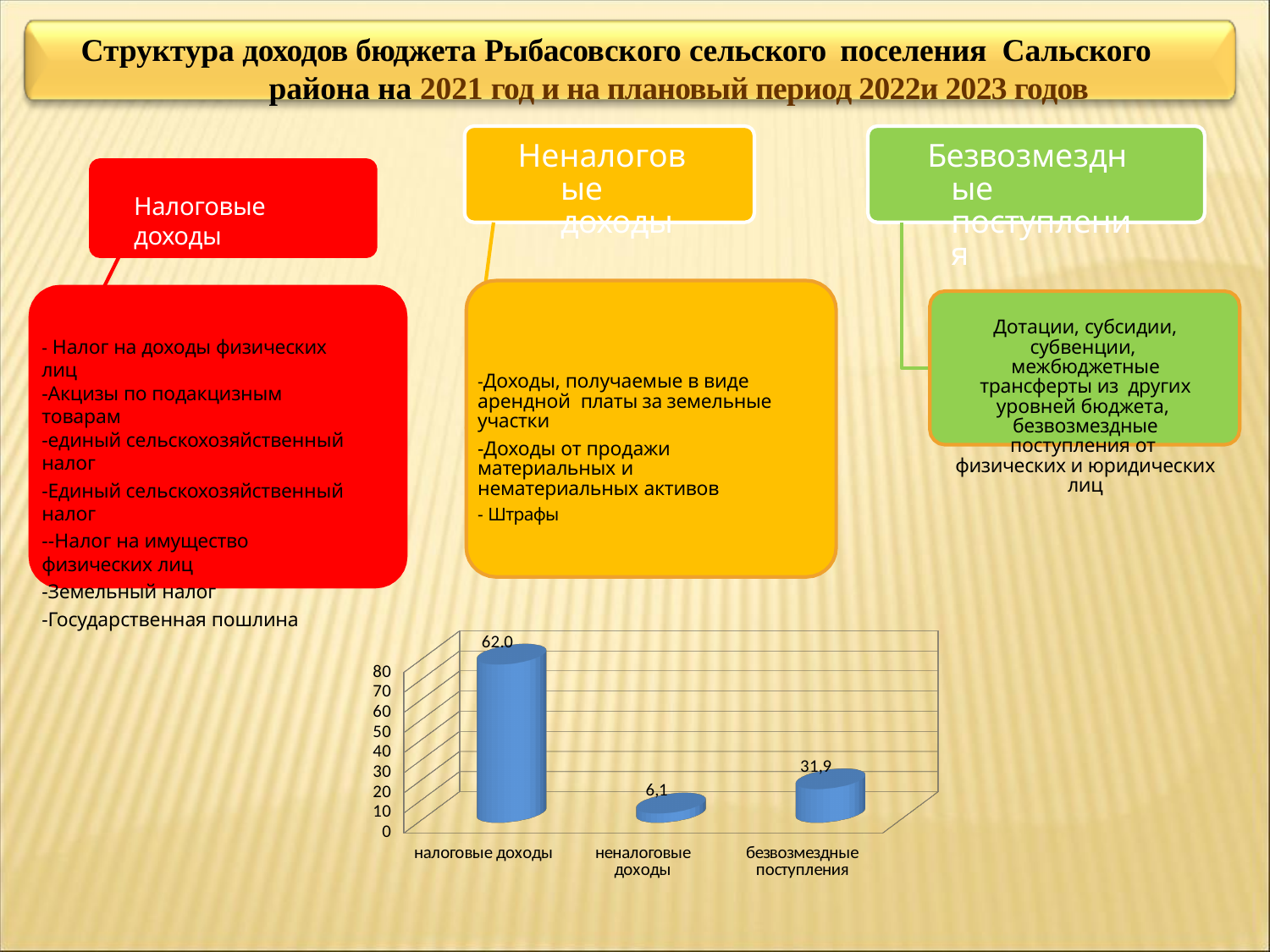
What is the difference between the values for налоговые доходы and безвозмездные поступления? 30,1 How many categories are shown in the chart? 3 What is the value shown for безвозмездные поступления in the chart? 31,9 What is the value shown for неналоговые доходы in the chart? 6,1 Is the value for неналоговые доходы greater or less than 10? less Which category has the highest value in the chart? налоговые доходы What is the difference between the values for безвозмездные поступления and неналоговые доходы? 25,8 What is the value shown for налоговые доходы in the chart? 62,0 What kind of chart is shown on the slide? bar chart Which category has the lowest value in the chart? неналоговые доходы Which is larger: the value for безвозмездные поступления or the value for неналоговые доходы? безвозмездные поступления Is the value for налоговые доходы greater or less than 50? greater